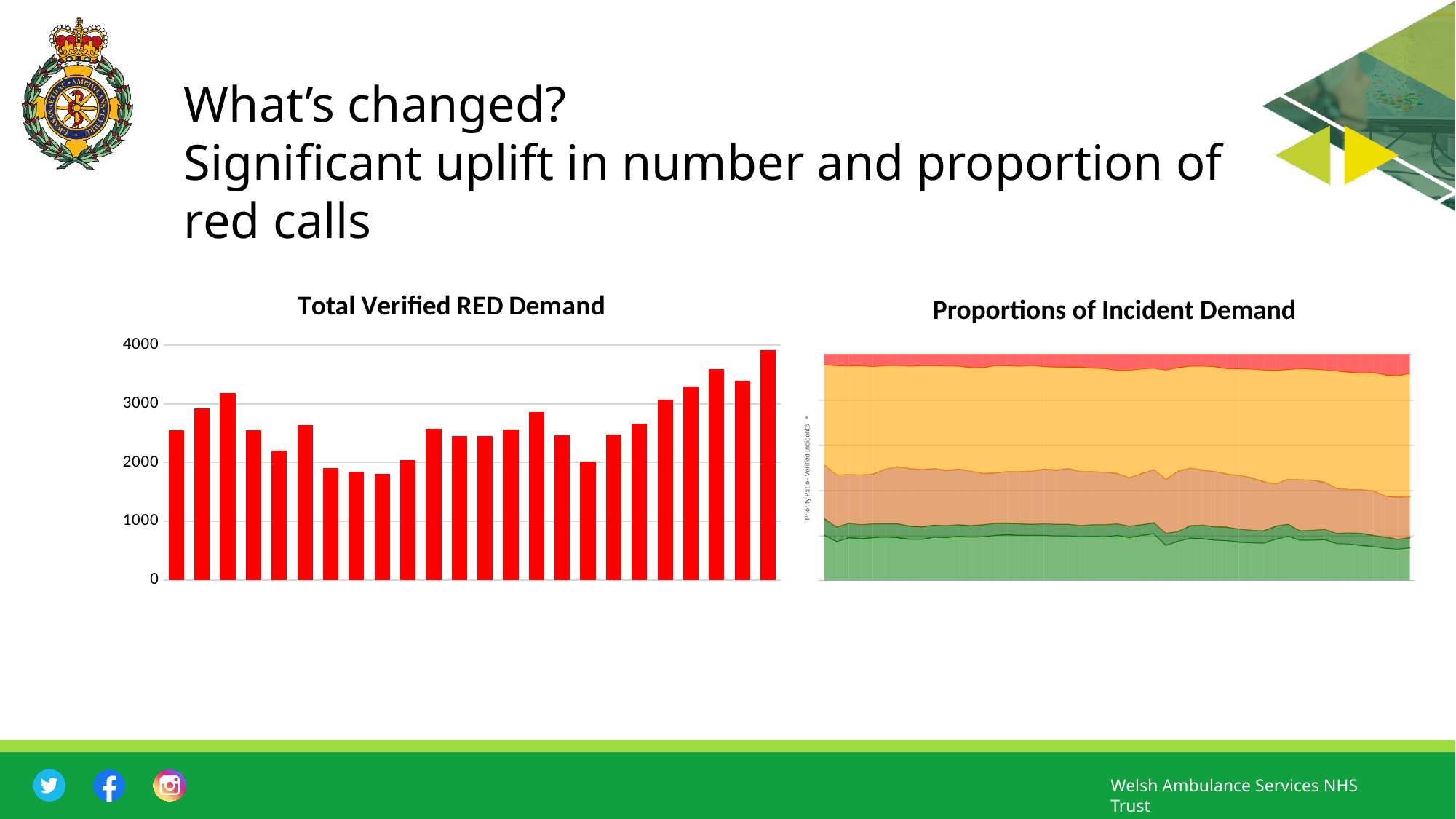
In the 'Total Verified RED Demand' chart, is the value of the first (leftmost) bar greater or less than 3000? less What colour are the bars in the 'Total Verified RED Demand' chart? red What is the highest value shown on the vertical axis of the 'Total Verified RED Demand' chart? 4000 In the 'Total Verified RED Demand' chart, how many bars are plotted? 24 In the 'Total Verified RED Demand' chart, which is larger, the first bar or the last bar? the last bar In the 'Total Verified RED Demand' chart, which bar is the highest? the last (rightmost) bar In the 'Total Verified RED Demand' chart, do the values rise or fall over the last six bars? rise In the 'Total Verified RED Demand' chart, is the value of the first bar greater or less than 2000? greater What kind of chart is 'Proportions of Incident Demand'? stacked area chart What kind of chart is 'Total Verified RED Demand'? bar chart In the 'Total Verified RED Demand' chart, is the value of the rightmost bar greater or less than 3000? greater